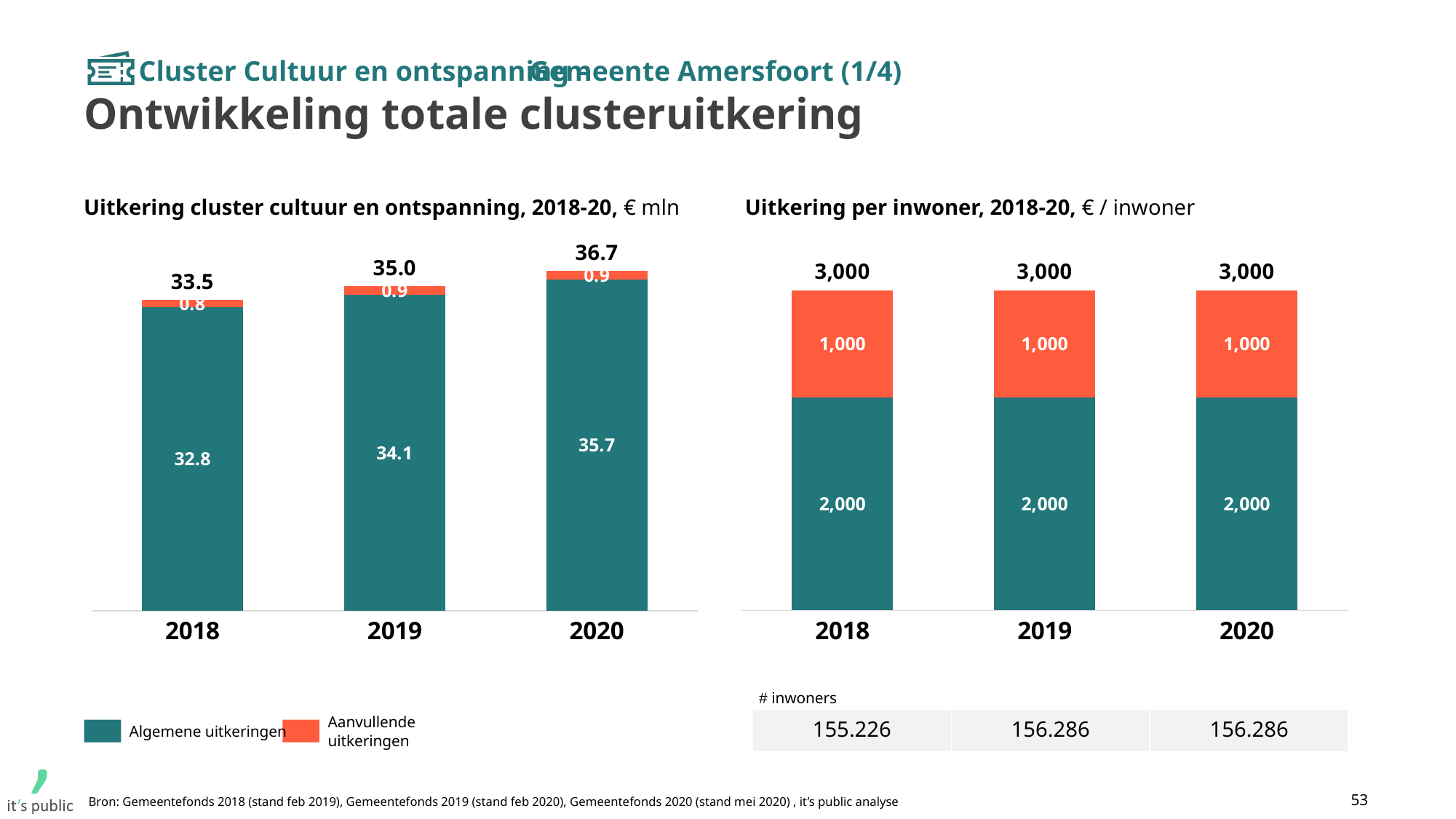
In the chart 'Uitkering cluster cultuur en ontspanning, 2018-20', what is the difference between the Algemene uitkeringen values for 2020 and 2018? 2.9 In the chart 'Uitkering cluster cultuur en ontspanning, 2018-20', what is the value of Aanvullende uitkeringen for 2018? 0.8 In the chart 'Uitkering per inwoner, 2018-20', what is the total for 2019? 3,000 In the chart 'Uitkering cluster cultuur en ontspanning, 2018-20', which year has the highest total? 2020 In the chart 'Uitkering per inwoner, 2018-20', which is larger for 2020: Algemene uitkeringen or Aanvullende uitkeringen? Algemene uitkeringen How many series does the legend list for the charts on the slide? 2 In the chart 'Uitkering cluster cultuur en ontspanning, 2018-20', do the totals rise or fall from 2018 to 2020? rise How many years are shown on the x axis of the chart 'Uitkering cluster cultuur en ontspanning, 2018-20'? 3 In the chart 'Uitkering cluster cultuur en ontspanning, 2018-20', what is the total for 2020? 36.7 In the chart 'Uitkering cluster cultuur en ontspanning, 2018-20', what is the value of Algemene uitkeringen for 2019? 34.1 In the chart 'Uitkering cluster cultuur en ontspanning, 2018-20', which year has the lowest total? 2018 In the chart 'Uitkering per inwoner, 2018-20', what is the value of Algemene uitkeringen for 2018? 2,000